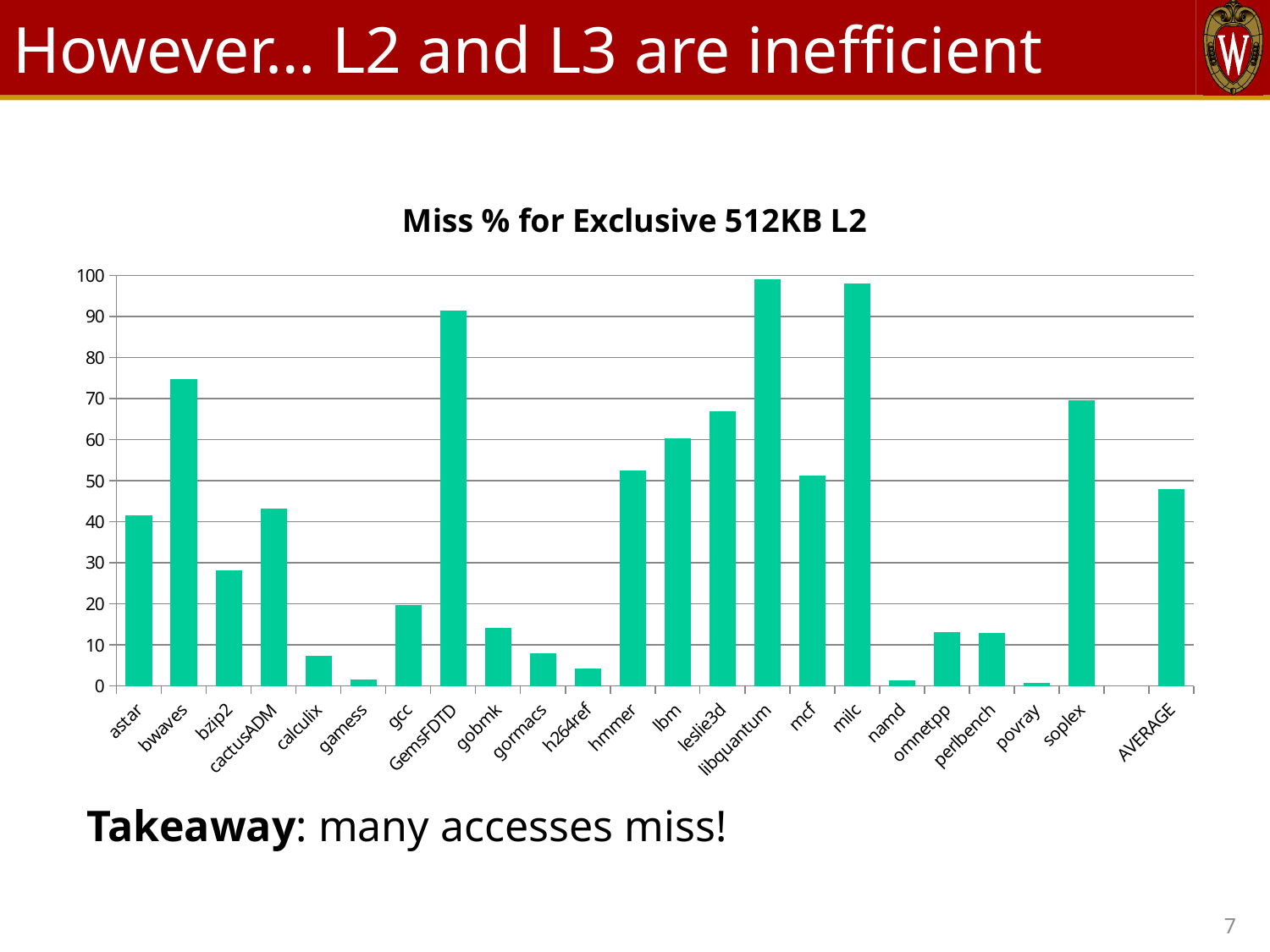
Is the value for calculix greater or less than 10? less Which has a higher miss %, bwaves or bzip2? bwaves How many bars (categories) are plotted in the chart? 23 What is the title of the chart? Miss % for Exclusive 512KB L2 Which has a higher miss %, leslie3d or lbm? leslie3d Is the value for GemsFDTD greater or less than 80? greater Is the value for gcc greater or less than 30? less Which has a higher miss %, soplex or hmmer? soplex What kind of chart is shown on the slide? bar chart